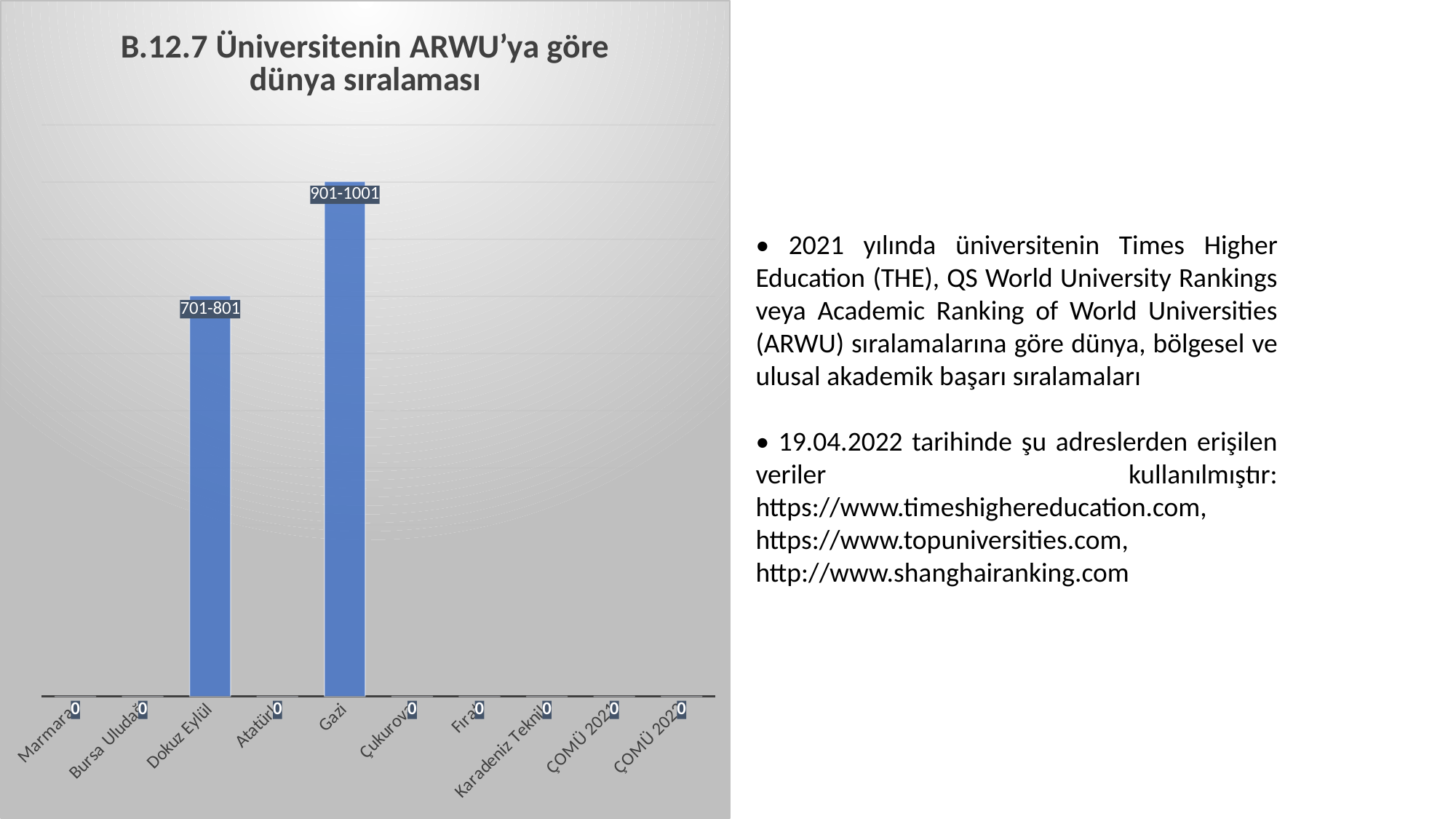
What value is shown for Karadeniz Teknik? 0 What colour are the bars in the chart? Blue What value is shown for Gazi? 901-1001 Which university has the tallest bar in the chart? Gazi What value is shown for Marmara? 0 What kind of chart is shown on the slide? Bar chart How many categories in the chart have a value of 0? 8 How many categories are shown on the x axis of the chart? 10 What value is shown for Dokuz Eylül? 701-801 What is the title of the chart? B.12.7 Üniversitenin ARWU'ya göre dünya sıralaması What value is shown for ÇOMÜ 2021? 0 Which bar is taller, Gazi or Dokuz Eylül? Gazi